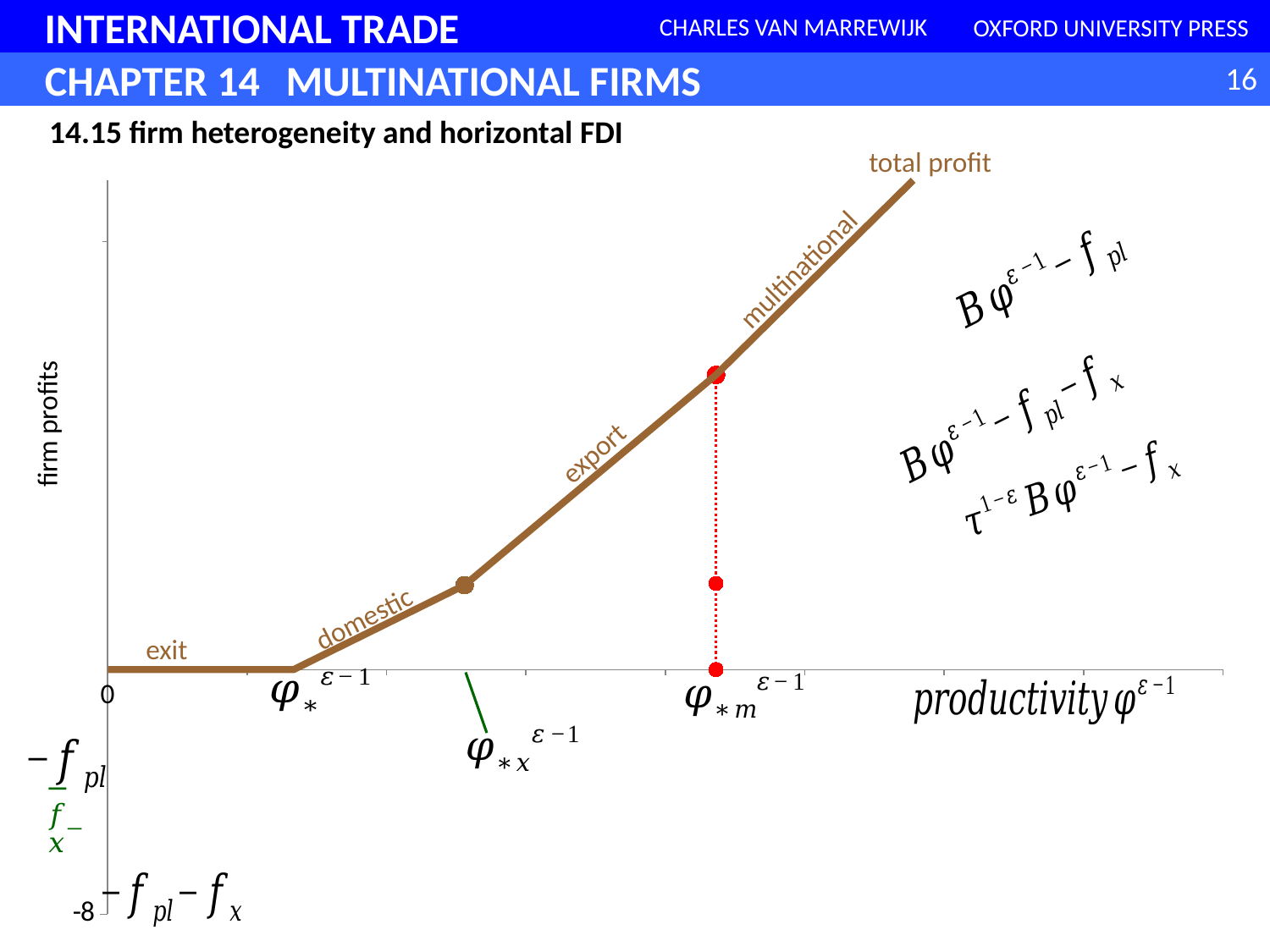
Which segment has the steeper slope, domestic or export? export What is the lowest value labeled on the vertical axis? -8 How many labeled segments (regimes) does the total profit line have? 4 What is the label of the vertical axis? firm profits How many productivity threshold points are marked on the x axis? 3 Does the total profit line rise or fall as productivity increases along the x axis? rises What kind of chart is shown on the slide? line chart What is the label written at the top end of the plotted line? total profit Which labeled segment of the total profit line is the steepest? multinational Which labeled segment of the total profit line is flat (has zero slope)? exit